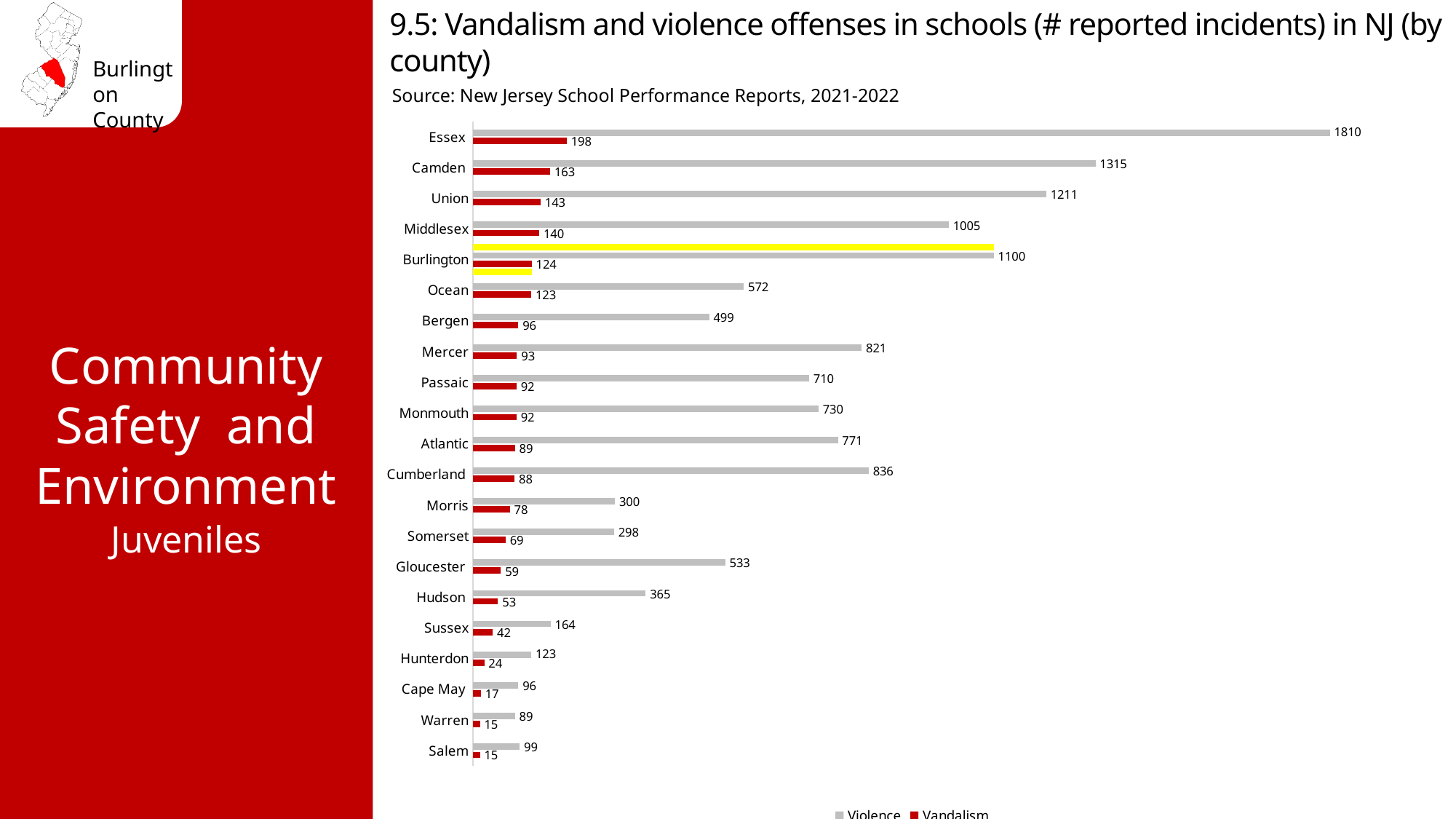
Which county has the lowest number of violence incidents? Warren Which series is shown in red in the chart? Vandalism Which county has the highest number of violence incidents? Essex What is the number of reported vandalism incidents for Hunterdon? 24 What is the difference between the violence and vandalism incidents for Burlington? 976 What is the number of reported violence incidents for Burlington? 1100 What is the difference between the violence incidents for Essex and Camden? 495 What type of chart is shown on the slide? Bar chart How many series does the legend list? 2 What is the number of reported vandalism incidents for Camden? 163 How many counties are shown in the chart? 21 Which county has more vandalism incidents, Ocean or Bergen? Ocean